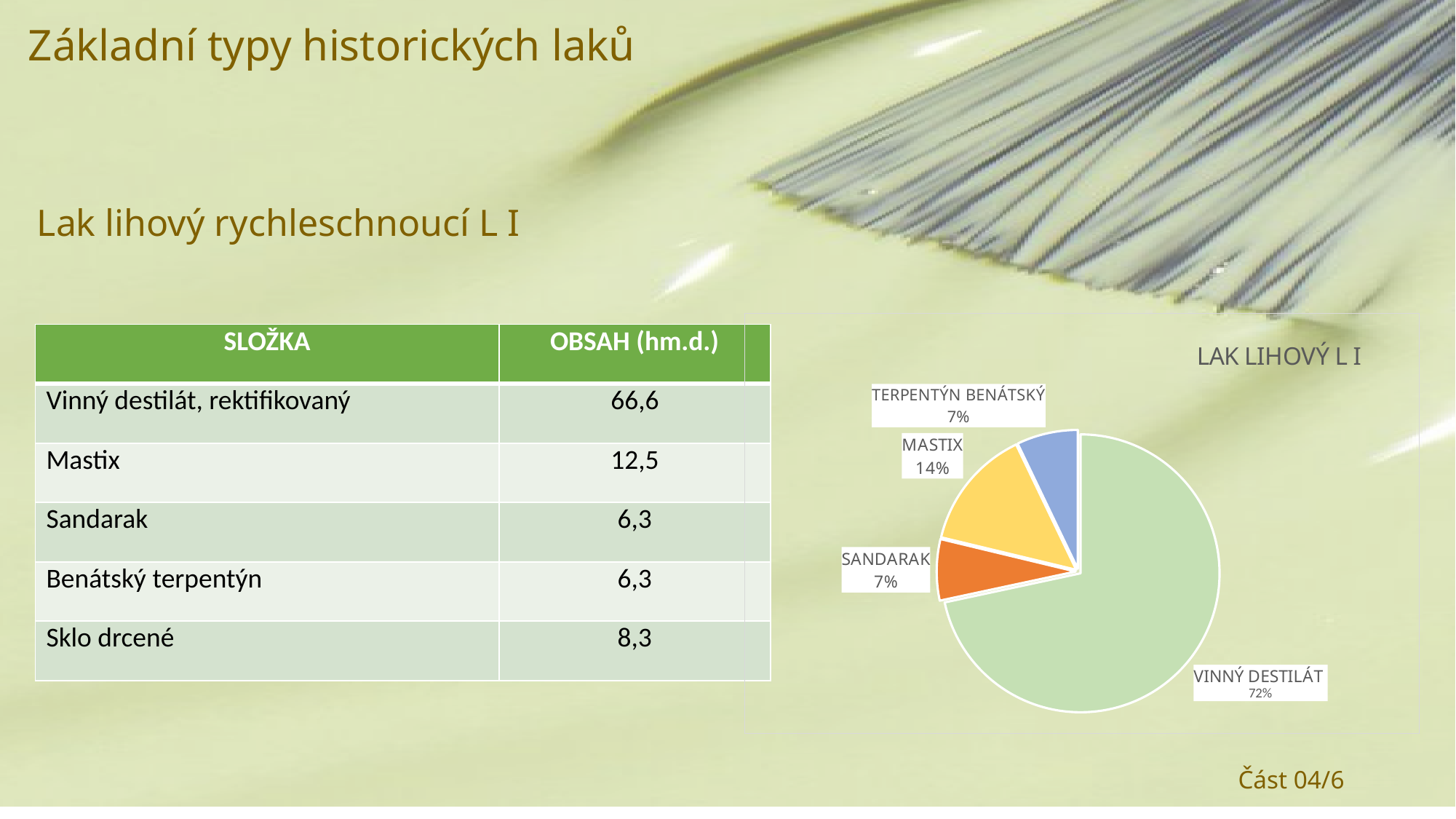
Which colour is the VINNÝ DESTILÁT slice in the pie chart? green What kind of chart is shown on the slide? pie chart What share of the pie does VINNÝ DESTILÁT have? 72% What share of the pie does MASTIX have? 14% What share of the pie does TERPENTÝN BENÁTSKÝ have? 7% Which is larger in the pie chart, MASTIX or SANDARAK? MASTIX What is the difference in percentage points between the MASTIX slice and the SANDARAK slice? 7 What is the difference in percentage points between the VINNÝ DESTILÁT slice and the MASTIX slice? 58 Which slice of the pie chart is the largest? VINNÝ DESTILÁT What is the title of the pie chart? LAK LIHOVÝ L I How many slices does the pie chart have? 4